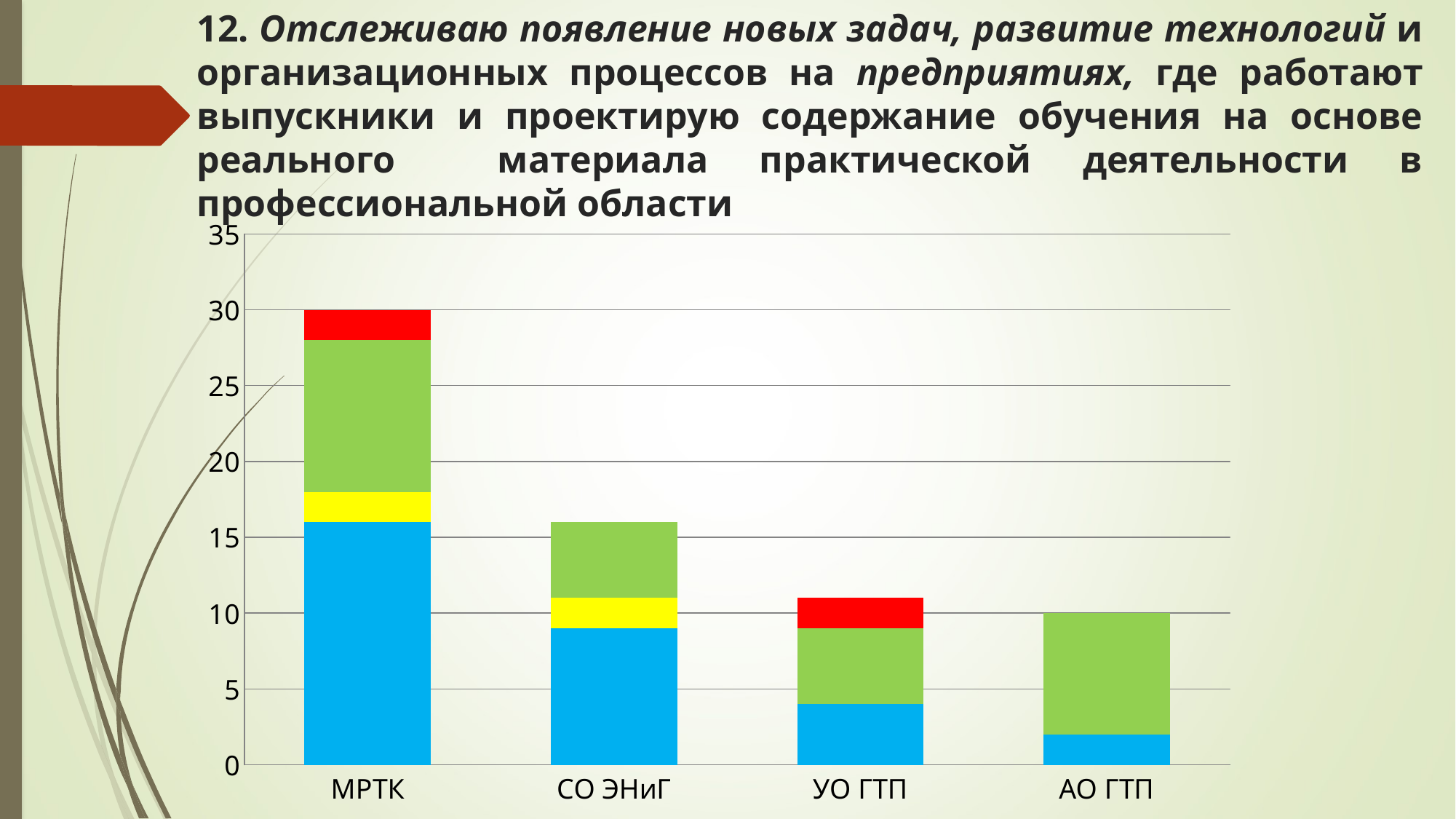
What is the total height of the stacked bar for АО ГТП? 10 Is the total for СО ЭНиГ greater or less than 15? greater Which colour is the bottom segment of every bar? blue How many categories are shown on the x axis of the chart? 4 What kind of chart is shown on the slide? stacked bar chart Which stacked bar is taller, СО ЭНиГ or УО ГТП? СО ЭНиГ What is the difference between the total for МРТК and the total for АО ГТП? 20 Is the total for УО ГТП greater or less than 15? less What is the total height of the stacked bar for МРТК? 30 Is the blue segment for МРТК greater or less than 20? less How many coloured segments make up the МРТК bar? 4 Which category has the tallest stacked bar? МРТК